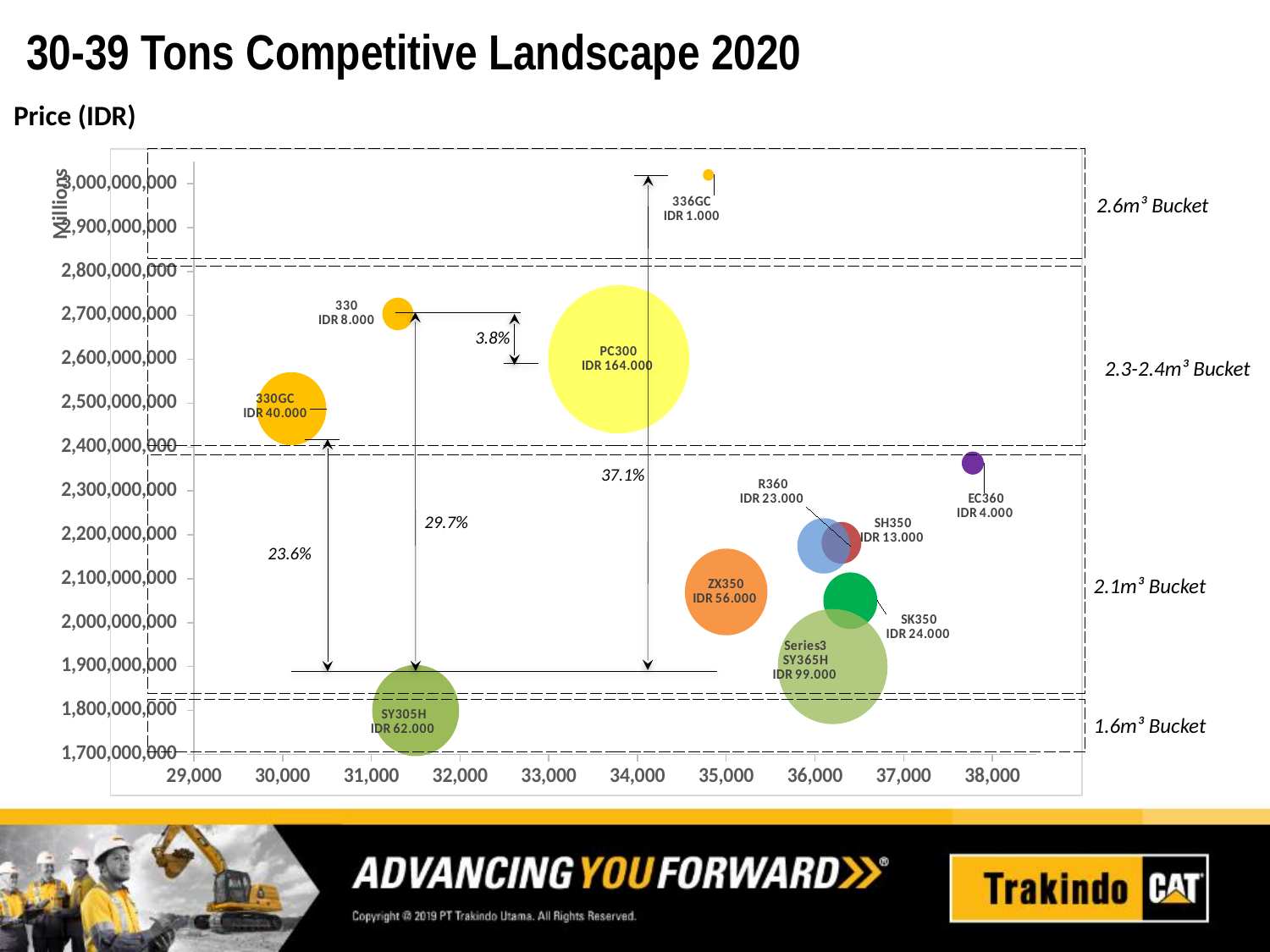
What percentage is annotated between the 330 and PC300 bubbles? 3.8% What is the title of the chart on the slide? 30-39 Tons Competitive Landscape 2020 What kind of chart is shown on the slide? Bubble chart What IDR value is printed on the PC300 bubble? IDR 164.000 Which model's bubble sits at the lowest price on the chart? SY305H What IDR value is printed on the ZX350 bubble? IDR 56.000 Which has the higher price on the chart, the 330 or the PC300? 330 Which model's bubble sits at the highest price on the chart? 336GC What IDR value is printed next to the 336GC bubble? IDR 1.000 How many labelled bubbles are plotted on the chart? 11 Is the price for PC300 greater or less than 2,500,000,000? greater Is the price for ZX350 greater or less than 2,200,000,000? less